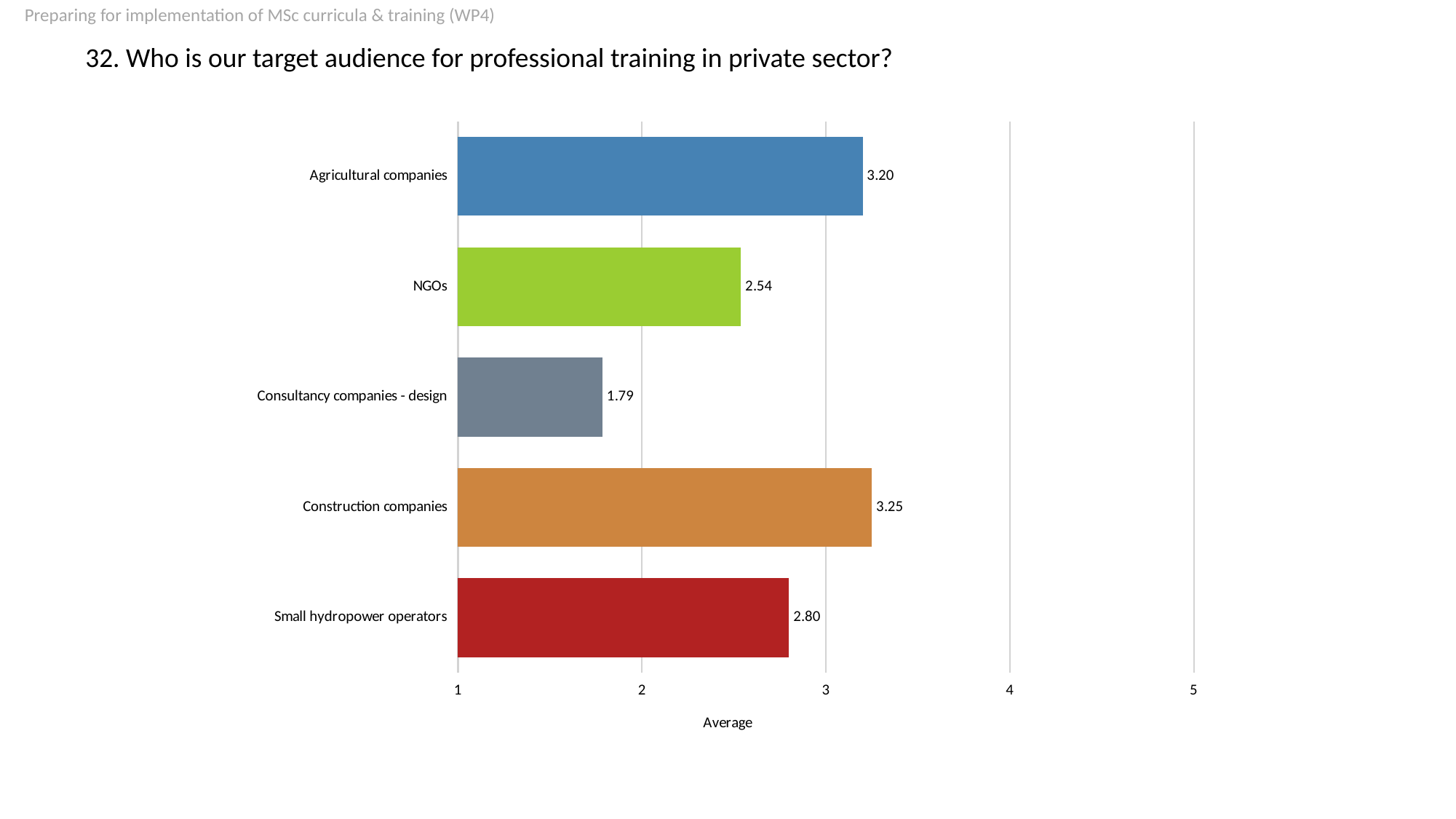
What kind of chart is shown on the slide? Bar chart Is the value for Agricultural companies greater or less than 3? greater How many categories are shown in the chart? 5 What is the average value for Consultancy companies - design? 1.79 Which category has the highest average value? Construction companies What is the average value for Agricultural companies? 3.20 Which has a larger value, NGOs or Small hydropower operators? Small hydropower operators Which category has the lowest average value? Consultancy companies - design What is the difference between the values for Construction companies and Consultancy companies - design? 1.46 What is the average value for NGOs? 2.54 What is the label of the horizontal axis? Average What is the average value for Small hydropower operators? 2.80